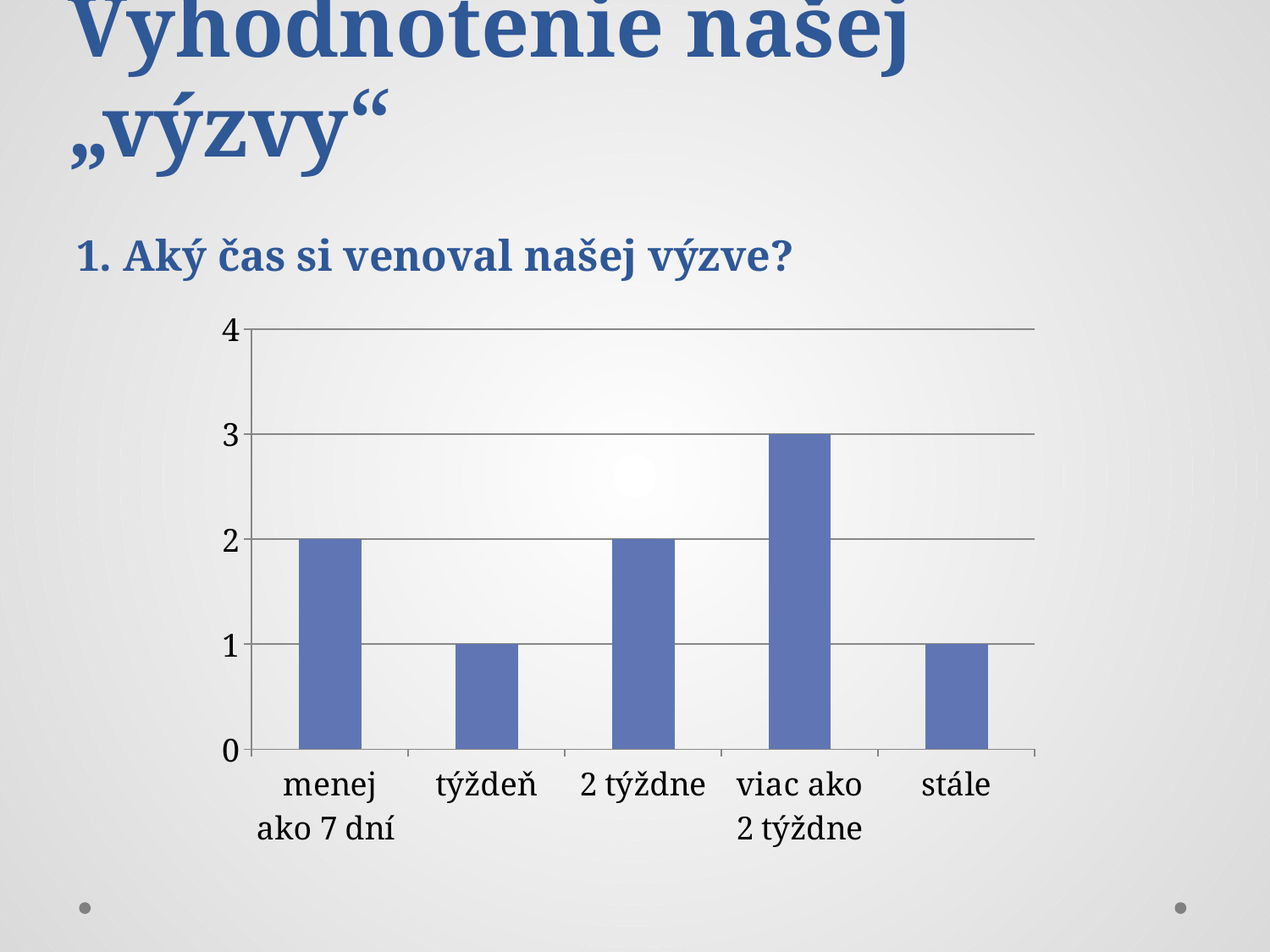
Which is larger, the value for "2 týždne" or the value for "stále"? 2 týždne Is the value for "viac ako 2 týždne" greater or less than 2? greater What is the value for "menej ako 7 dní"? 2 How many categories are shown on the x axis? 5 Which category has the highest value? viac ako 2 týždne What question is the chart answering, as written above it? 1. Aký čas si venoval našej výzve? What is the difference between the values for "viac ako 2 týždne" and "týždeň"? 2 What is the value for "viac ako 2 týždne"? 3 What is the highest value shown on the vertical axis? 4 What is the value for "stále"? 1 What kind of chart is shown on the slide? bar chart What is the value for "týždeň"? 1